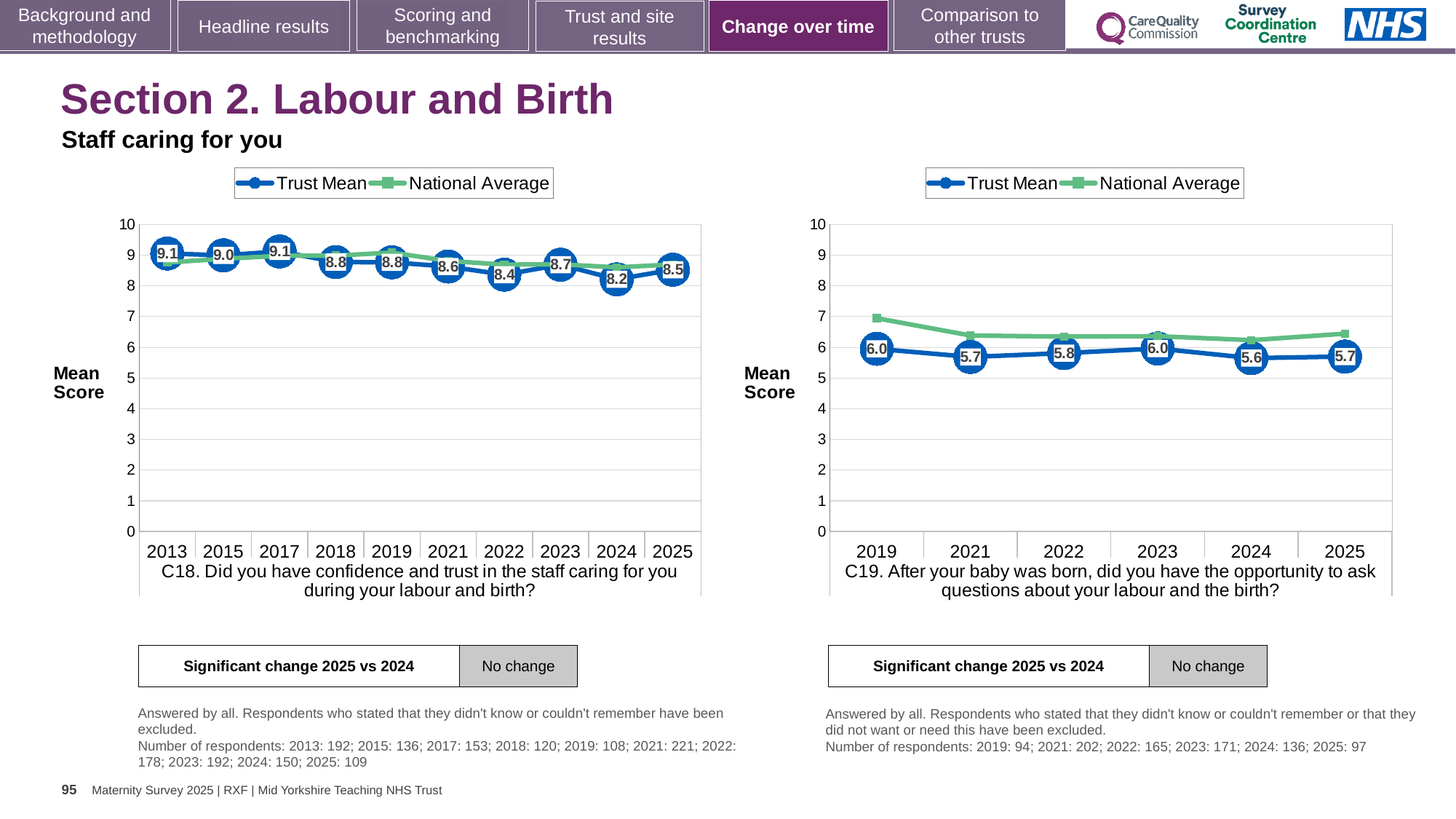
In the C18 chart on the left, what is the Trust Mean score for 2024? 8.2 In the C18 chart on the left, what is the difference between the Trust Mean scores for 2025 and 2024? 0.3 How many years are plotted on the x axis of the C18 chart on the left? 10 In the C19 chart on the right, which is larger, the Trust Mean score for 2019 or for 2024? 2019 What type of chart is the C18 chart on the left? Line chart In the C19 chart on the right, which year has the lowest Trust Mean score? 2024 In the C18 chart on the left, which year has the lowest Trust Mean score? 2024 In the C19 chart on the right, what is the Trust Mean score for 2025? 5.7 In the C19 chart on the right, is the National Average value for 2019 greater or less than 6? greater In the C19 chart on the right, what is the Trust Mean score for 2023? 6.0 In the C18 chart on the left, what is the Trust Mean score for 2013? 9.1 How many series does the legend of the C19 chart on the right list? 2